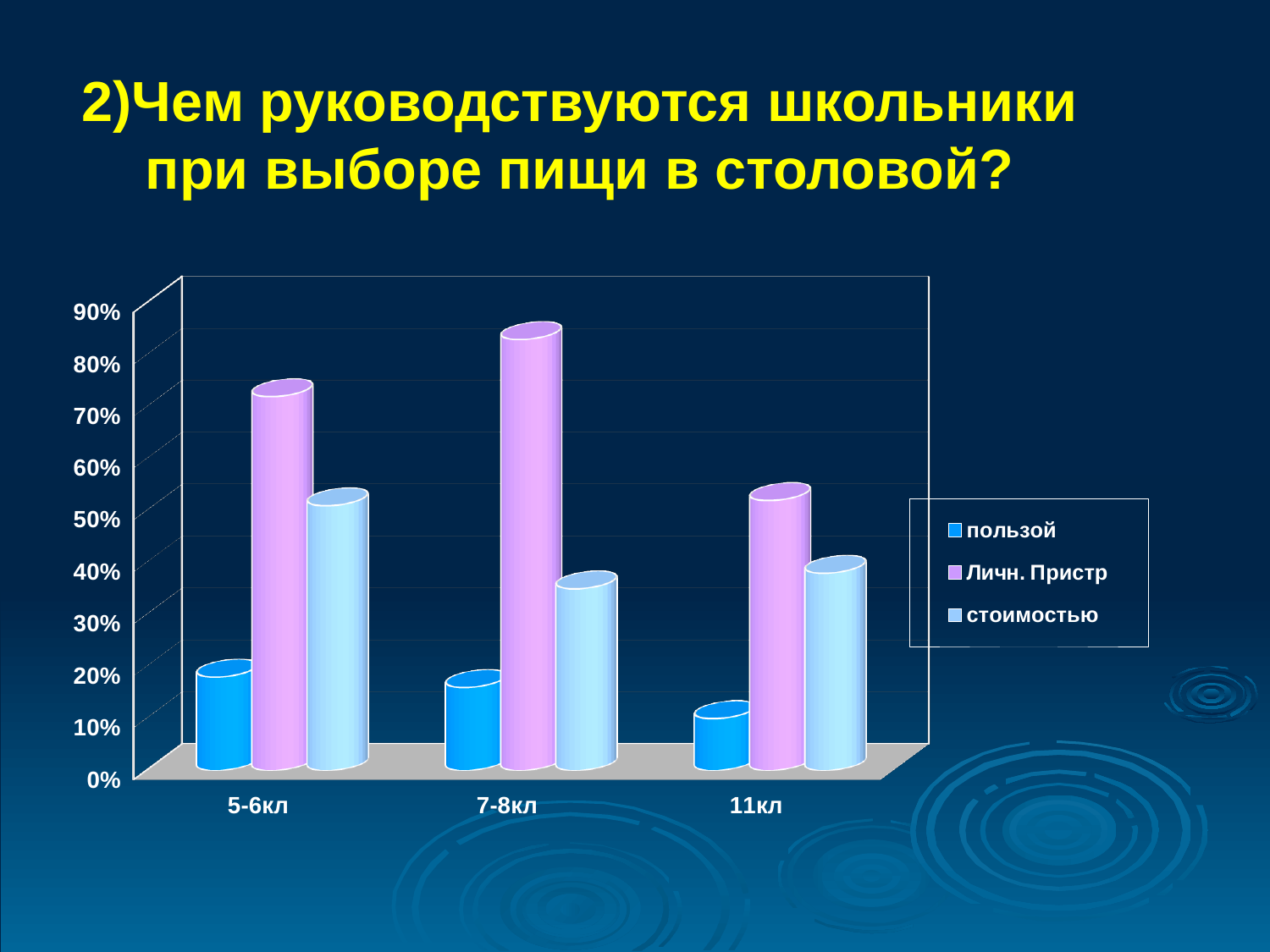
What kind of chart is shown on the slide? bar chart For which class group is the value for стоимостью highest? 5-6кл For which class group is the value for Личн. Пристр highest? 7-8кл For which class group is the value for Личн. Пристр lowest? 11кл For 5-6кл, which is larger: Личн. Пристр or стоимостью? Личн. Пристр What are the three entries listed in the legend? пользой, Личн. Пристр, стоимостью How many class groups (categories) are shown on the x axis? 3 Is the value for Личн. Пристр in 7-8кл greater or less than 70%? greater Does the value for пользой rise or fall from 5-6кл to 11кл? fall For which class group is the value for пользой lowest? 11кл Is the value for пользой in 11кл greater or less than 20%? less How many series does the legend list? 3